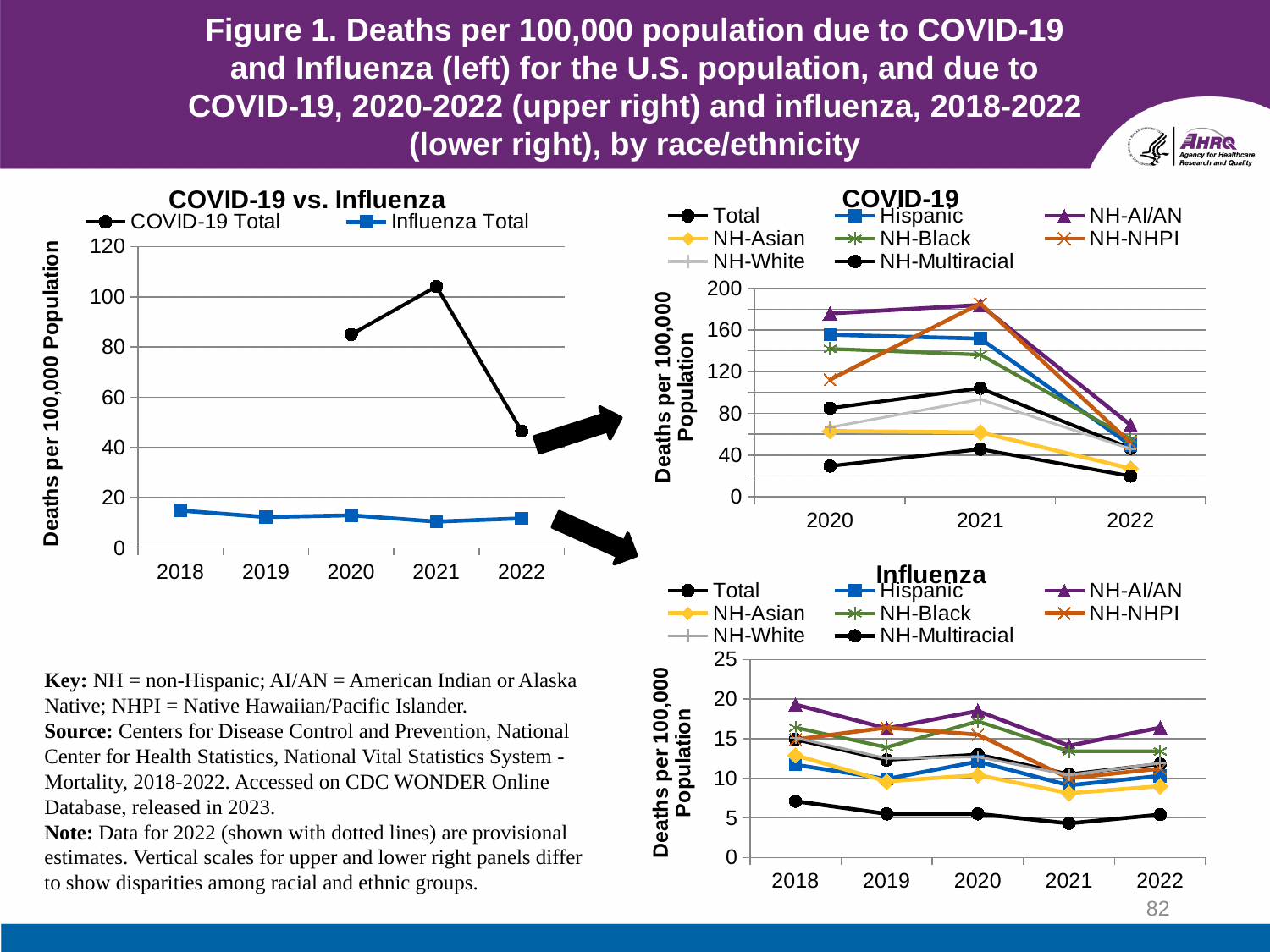
In the 'COVID-19 vs. Influenza' chart, how many series does the legend list? 2 In the 'COVID-19' chart (upper right), how many series does the legend list? 8 In the 'COVID-19 vs. Influenza' chart, which is larger for COVID-19 Total: 2020 or 2022? 2020 In the 'COVID-19 vs. Influenza' chart, is the COVID-19 Total value for 2021 greater or less than 100? greater What kind of chart is the 'COVID-19 vs. Influenza' chart on the left? Line chart In the 'COVID-19' chart (upper right), is the value for NH-Asian in 2022 greater or less than 40? less In the 'Influenza' chart (lower right), which group has the highest value in 2018? NH-AI/AN In the 'Influenza' chart (lower right), which group has the lowest value in 2021? NH-Multiracial In the 'COVID-19 vs. Influenza' chart, does the COVID-19 Total line rise or fall from 2021 to 2022? Fall In the 'COVID-19' chart (upper right), which group has the lowest value in 2022? NH-Multiracial In the 'COVID-19 vs. Influenza' chart, how many years are shown on the x axis? 5 In the 'COVID-19' chart (upper right), which group has the highest value in 2020? NH-AI/AN